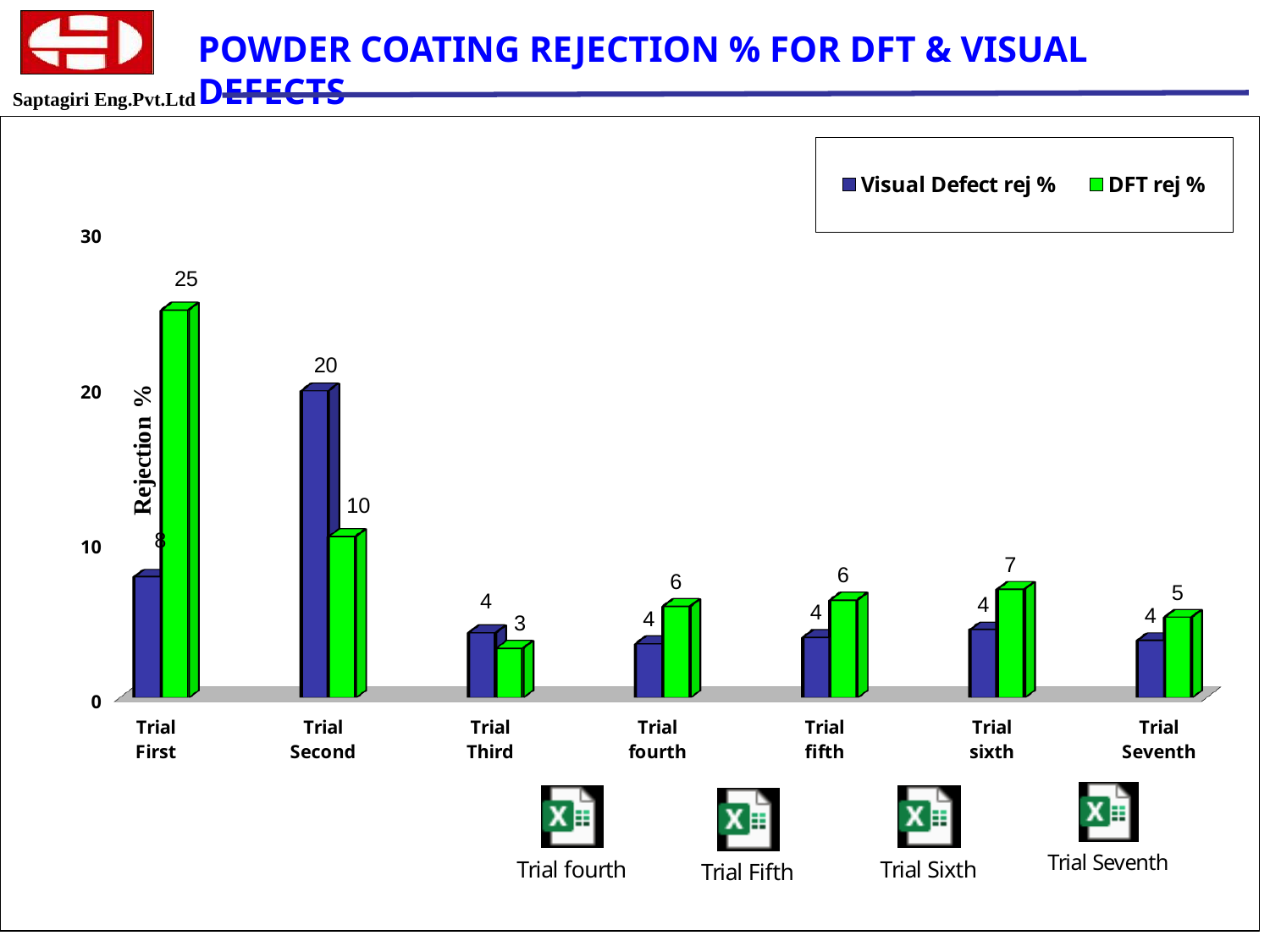
Which trial has the highest Visual Defect rej %? Trial Second What kind of chart is shown on the slide? Bar chart Which trial has the lowest DFT rej %? Trial Third What is the DFT rej % value for Trial First? 25 Which trial has the highest DFT rej %? Trial First Which is larger for Trial Second: the Visual Defect rej % or the DFT rej %? Visual Defect rej % Is the DFT rej % value for Trial First greater or less than 20? greater What is the DFT rej % value for Trial sixth? 7 What is the difference between the DFT rej % and the Visual Defect rej % for Trial First? 17 How many trials are shown on the x axis? 7 What is the Visual Defect rej % value for Trial Second? 20 How many series does the legend list? 2